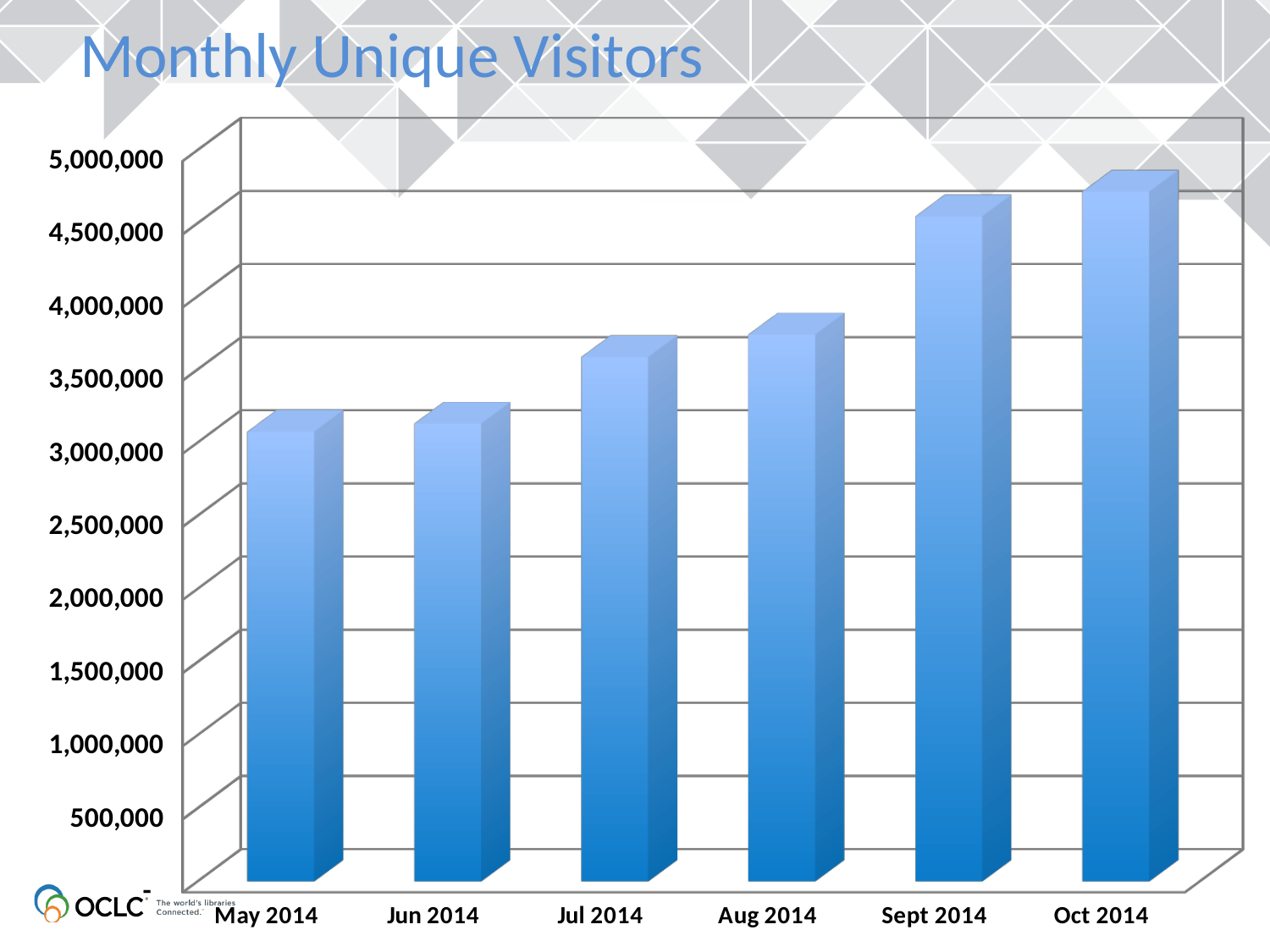
Which month has the highest number of monthly unique visitors? Oct 2014 Is the value for Jun 2014 greater or less than 3,500,000? less Which month has the lowest number of monthly unique visitors? May 2014 What kind of chart is shown on the slide? bar chart Is the value for May 2014 greater or less than 3,000,000? greater Is the value for Sept 2014 greater or less than 4,000,000? greater What is the title of the chart? Monthly Unique Visitors Do the monthly unique visitors rise or fall from May 2014 to Oct 2014? rise How many months are shown on the x axis of the chart? 6 Which month has more unique visitors, Jul 2014 or Sept 2014? Sept 2014